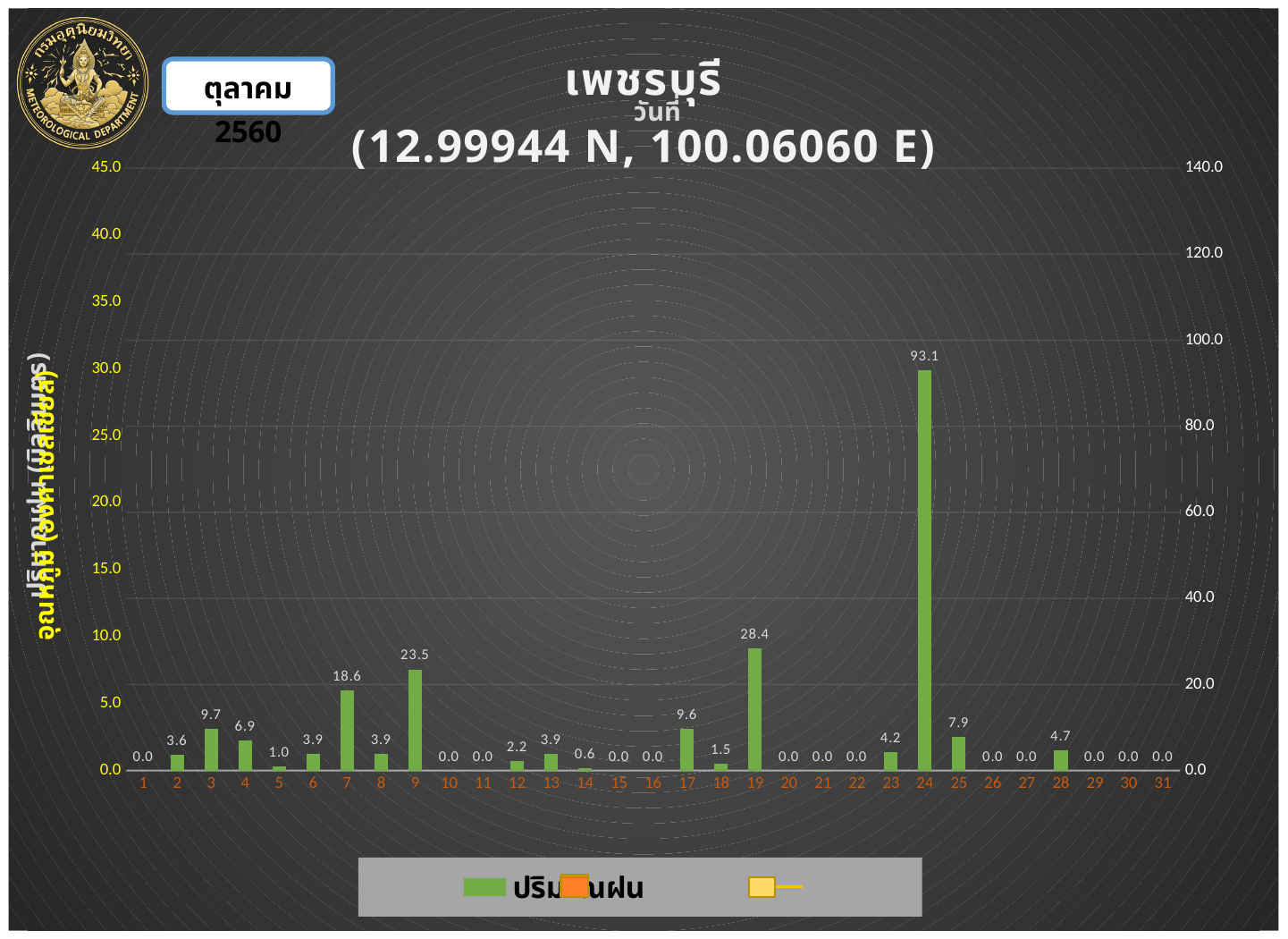
What is the rainfall value shown for day 7? 18.6 What is the rainfall value shown for day 24? 93.1 What is the difference between the rainfall values for day 24 and day 19? 64.7 What is the rainfall value shown for day 9? 23.5 What coordinates are given in the chart title? 12.99944 N, 100.06060 E What is the difference between the rainfall values for day 9 and day 7? 4.9 How many days are shown on the x axis of the chart? 31 What is the rainfall value shown for day 19? 28.4 What kind of chart is shown on the slide? bar chart Which has a larger rainfall value, day 17 or day 25? day 17 Which day has the highest rainfall value? 24 Which has a larger rainfall value, day 3 or day 4? day 3